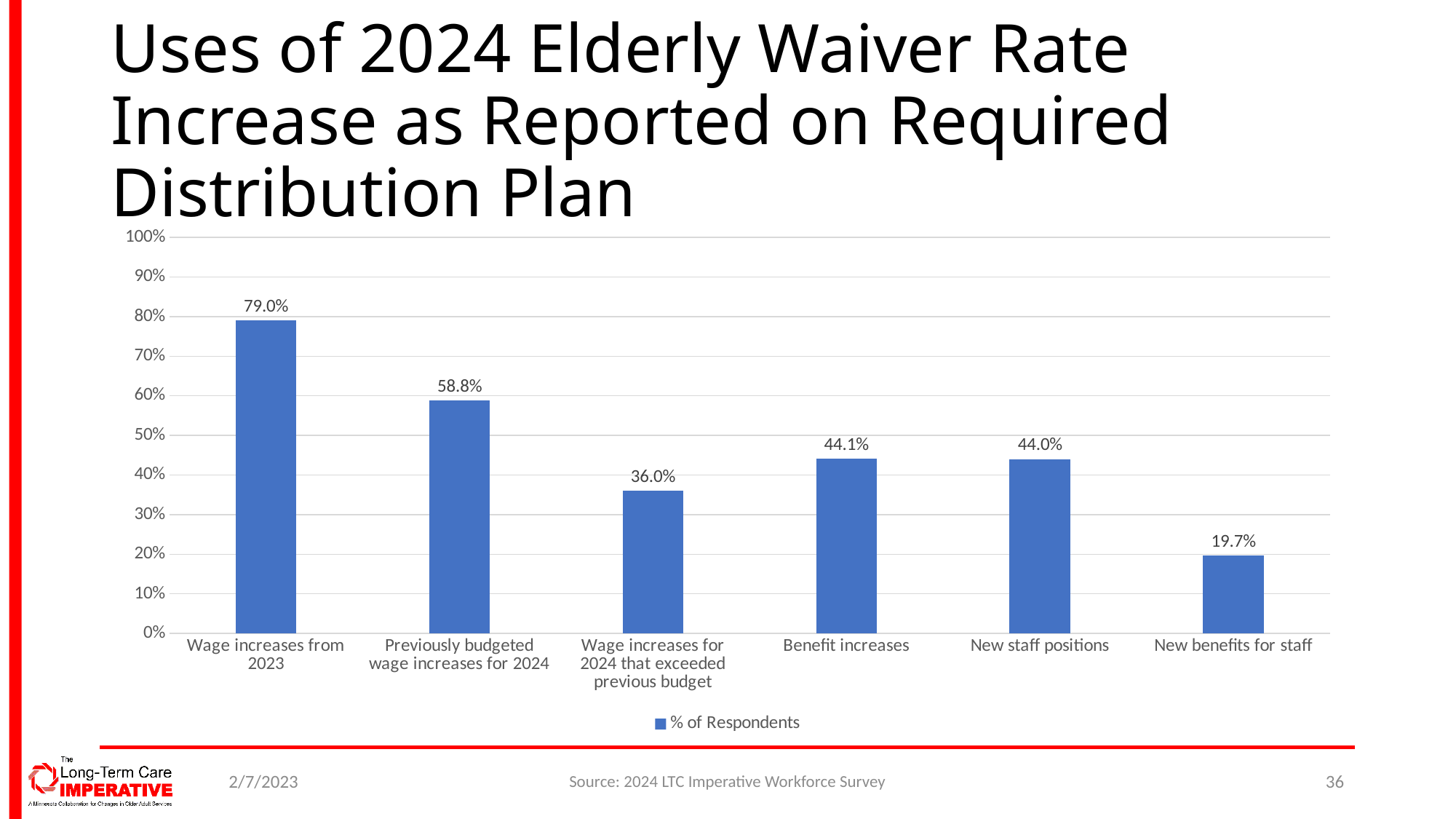
How many categories are shown on the chart? 6 What kind of chart is shown on the slide? Bar chart What is the difference between the values for 'Benefit increases' and 'New benefits for staff'? 24.4% Is the value for 'Wage increases for 2024 that exceeded previous budget' greater or less than 40%? less What is the difference between the values for 'Wage increases from 2023' and 'Previously budgeted wage increases for 2024'? 20.2% What series name does the legend show? % of Respondents What percentage of respondents reported using the rate increase for wage increases from 2023? 79.0% Which category has the highest percentage of respondents? Wage increases from 2023 Which is larger: the value for 'Wage increases for 2024 that exceeded previous budget' or the value for 'New staff positions'? New staff positions What is the value for 'New benefits for staff'? 19.7% Which category has the lowest percentage of respondents? New benefits for staff What is the value for 'Previously budgeted wage increases for 2024'? 58.8%